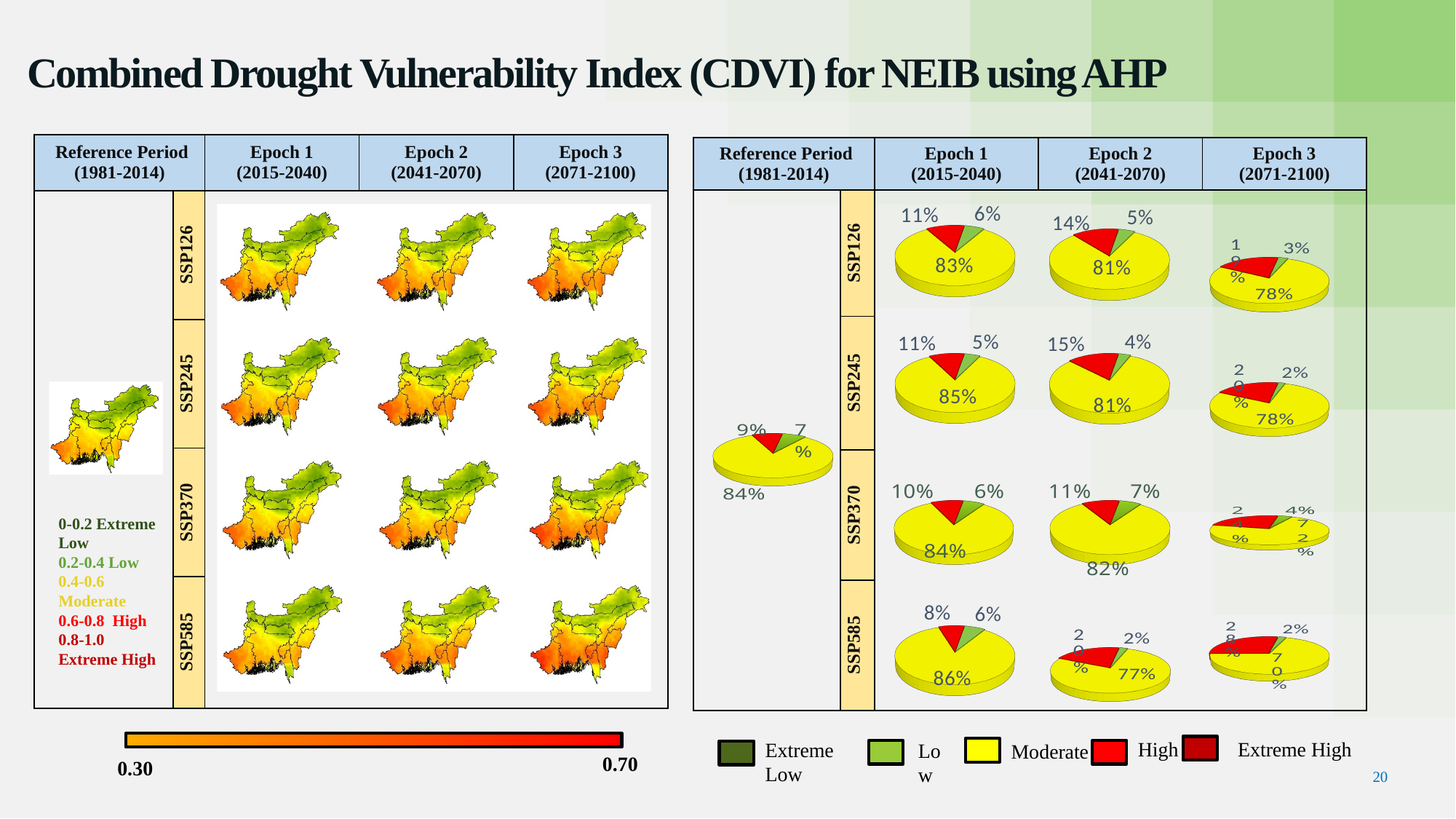
In the SSP370 Epoch 2 (2041-2070) pie chart, which category has the largest slice? Moderate In the SSP585 Epoch 1 (2015-2040) pie chart, what percentage is shown for the Low (green) slice? 6% In the Reference Period (1981-2014) pie chart, what percentage is shown for the Moderate (yellow) slice? 84% In the Reference Period (1981-2014) pie chart, what percentage is shown for the High (red) slice? 9% Is the High slice larger in the SSP126 Epoch 1 pie chart or in the SSP126 Epoch 2 pie chart? SSP126 Epoch 2 What is the difference between the Moderate percentage in the SSP245 Epoch 1 pie chart (85%) and in the SSP245 Epoch 3 pie chart (78%)? 7% What kind of chart is used in the right-hand panel to show the CDVI class shares? Pie chart In the SSP126 Epoch 1 (2015-2040) pie chart, what percentage is shown for the Moderate slice? 83% In the SSP245 Epoch 2 (2041-2070) pie chart, what percentage is shown for the High (red) slice? 15% In the SSP126 Epoch 2 (2041-2070) pie chart, which category has the smallest slice? Low How many categories does the legend below the pie charts list? 5 In the SSP585 Epoch 2 (2041-2070) pie chart, what percentage is shown for the Moderate slice? 77%